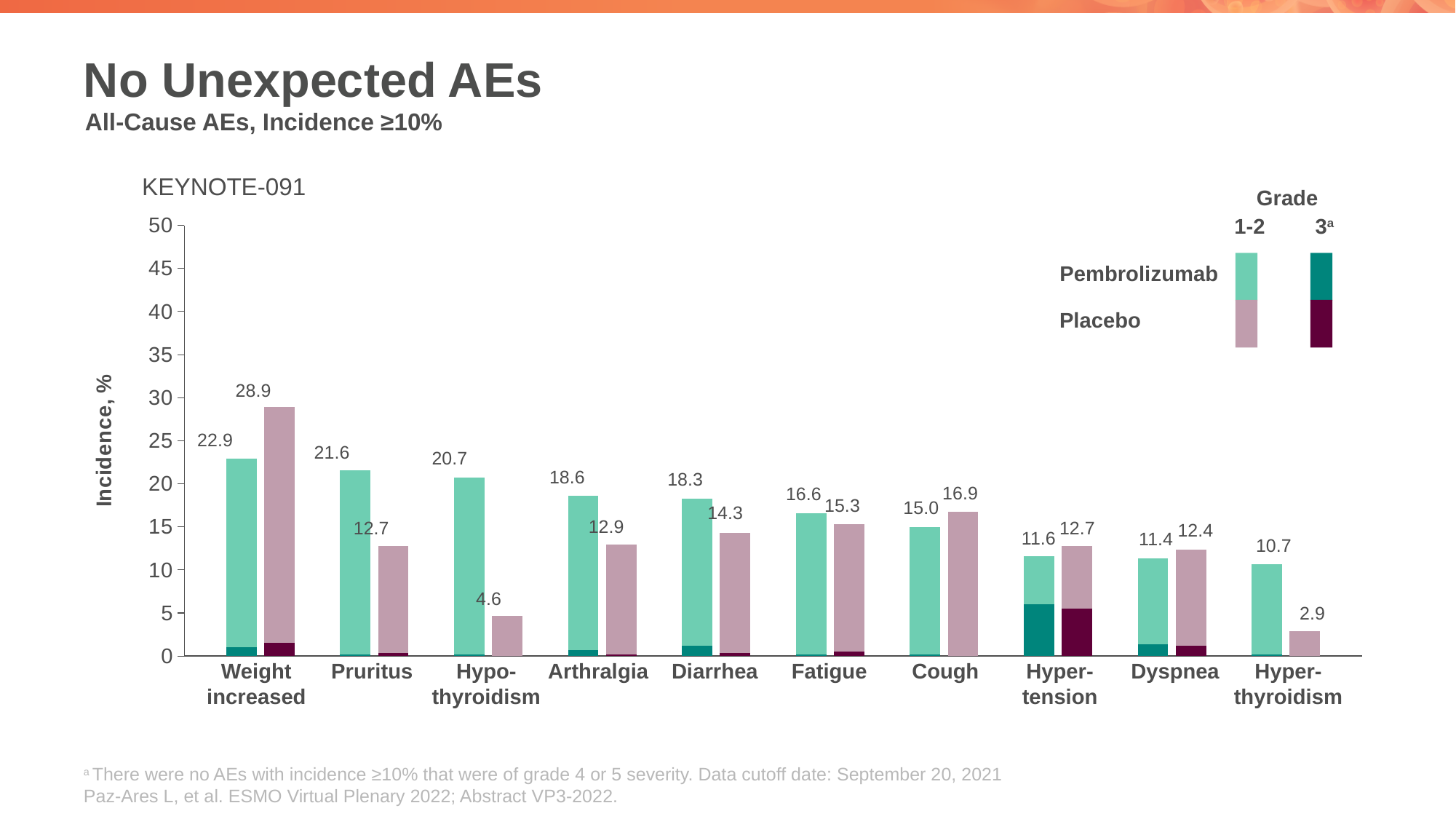
Which adverse event has the highest labeled incidence in the placebo group? Weight increased What type of chart is shown on the slide? Bar chart Which adverse event has the lowest labeled incidence in the pembrolizumab group? Hyperthyroidism What is the label of the y axis? Incidence, % How many adverse event categories are shown on the x axis? 10 Is the pembrolizumab incidence for diarrhea greater or less than 15? greater For pruritus, which group has the higher labeled incidence, pembrolizumab or placebo? Pembrolizumab What is the labeled incidence of hyperthyroidism in the placebo group? 2.9 What is the difference between the pembrolizumab and placebo labeled incidence for hypothyroidism? 16.1 What is the labeled incidence of hypothyroidism in the pembrolizumab group? 20.7 What is the labeled incidence of weight increased in the placebo group? 28.9 For cough, which group has the higher labeled incidence, pembrolizumab or placebo? Placebo